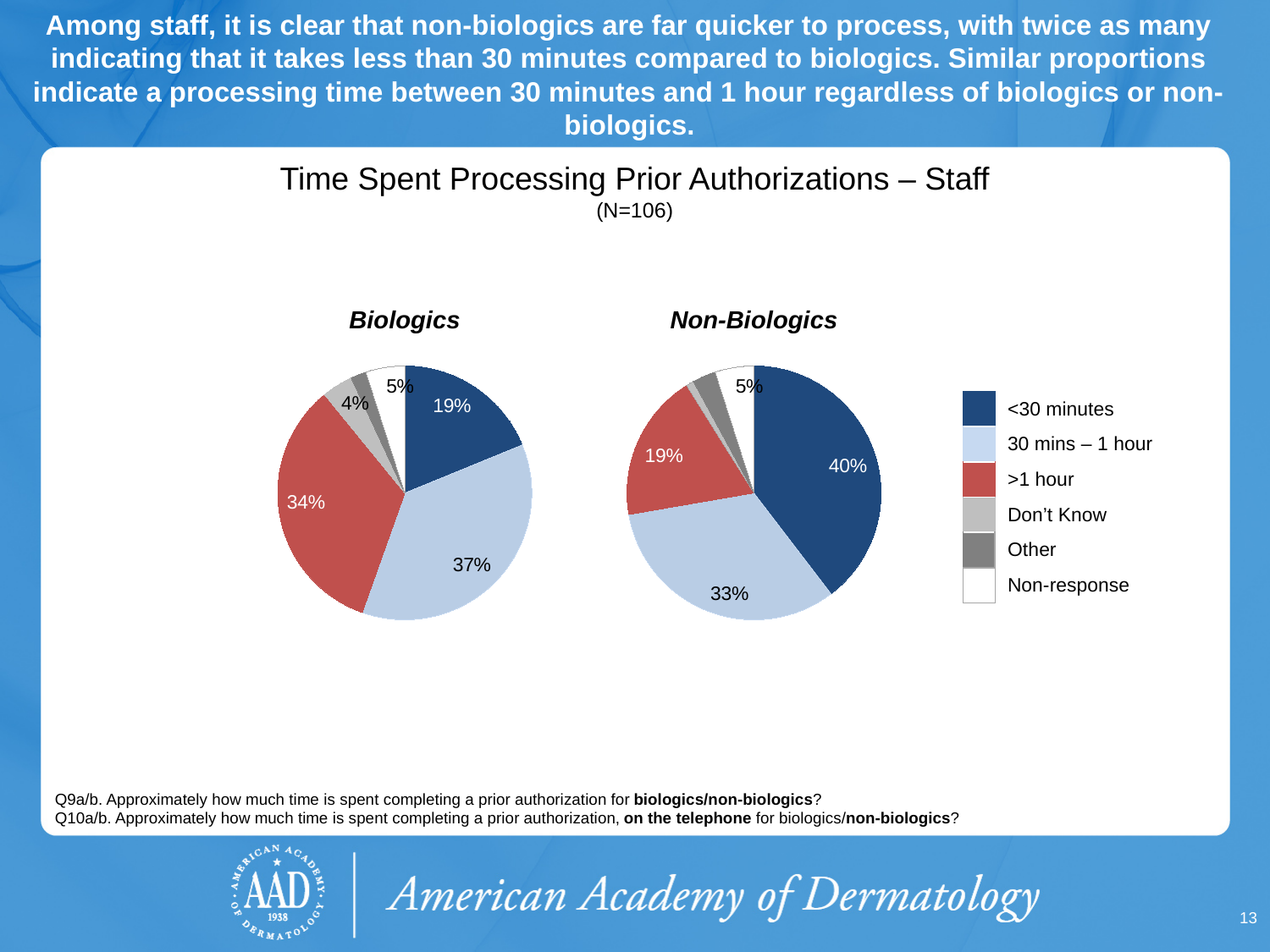
Which is larger: the >1 hour share in the Biologics chart or the >1 hour share in the Non-Biologics chart? Biologics In the Non-Biologics pie chart, what share of staff indicated <30 minutes? 40% What type of charts are shown on the slide? Pie charts How many categories does the legend list for the pie charts? 6 In the Biologics pie chart, which category has the largest slice? 30 mins – 1 hour In the Biologics pie chart, what share of staff indicated >1 hour? 34% What is the sample size (N) shown under the chart title? N=106 In the Biologics pie chart, what share of staff indicated 30 mins – 1 hour? 37% In the Non-Biologics pie chart, what share of staff indicated >1 hour? 19% What is the difference between the <30 minutes share in the Non-Biologics chart and the <30 minutes share in the Biologics chart? 21 percentage points In the Non-Biologics pie chart, which category has the largest slice? <30 minutes